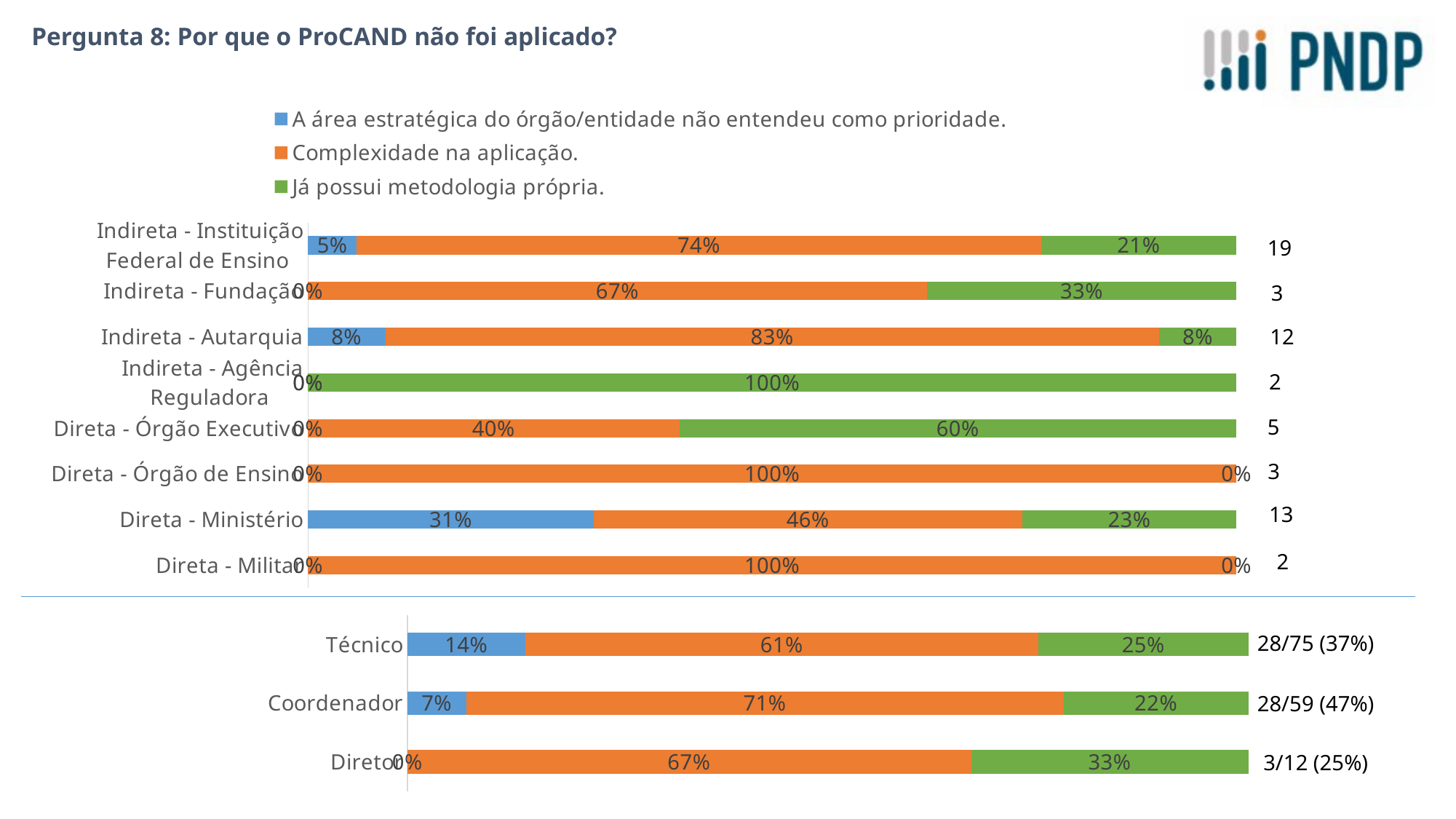
In the top chart, what is the difference between the 'Complexidade na aplicação.' share for 'Indireta - Autarquia' and for 'Direta - Ministério'? 37% What type of chart is the bottom chart? Stacked bar chart In the top chart, how many categories are plotted? 8 In the top chart, what is the count shown to the right of the 'Indireta - Instituição Federal de Ensino' bar? 19 In the top chart, which category has the highest share for 'A área estratégica do órgão/entidade não entendeu como prioridade.'? Direta - Ministério In the top chart, what percentage of 'Direta - Ministério' responses were 'A área estratégica do órgão/entidade não entendeu como prioridade.'? 31% In the bottom chart, what is the label shown to the right of the 'Técnico' bar? 28/75 (37%) In the top chart, what percentage of 'Direta - Órgão Executivo' responses were 'Já possui metodologia própria.'? 60% In the bottom chart, which role has a larger share for 'Já possui metodologia própria.': Técnico or Diretor? Diretor How many series does the legend list? 3 In the top chart, what percentage of 'Indireta - Autarquia' responses were 'Complexidade na aplicação.'? 83% In the bottom chart, what percentage of 'Coordenador' responses were 'Complexidade na aplicação.'? 71%